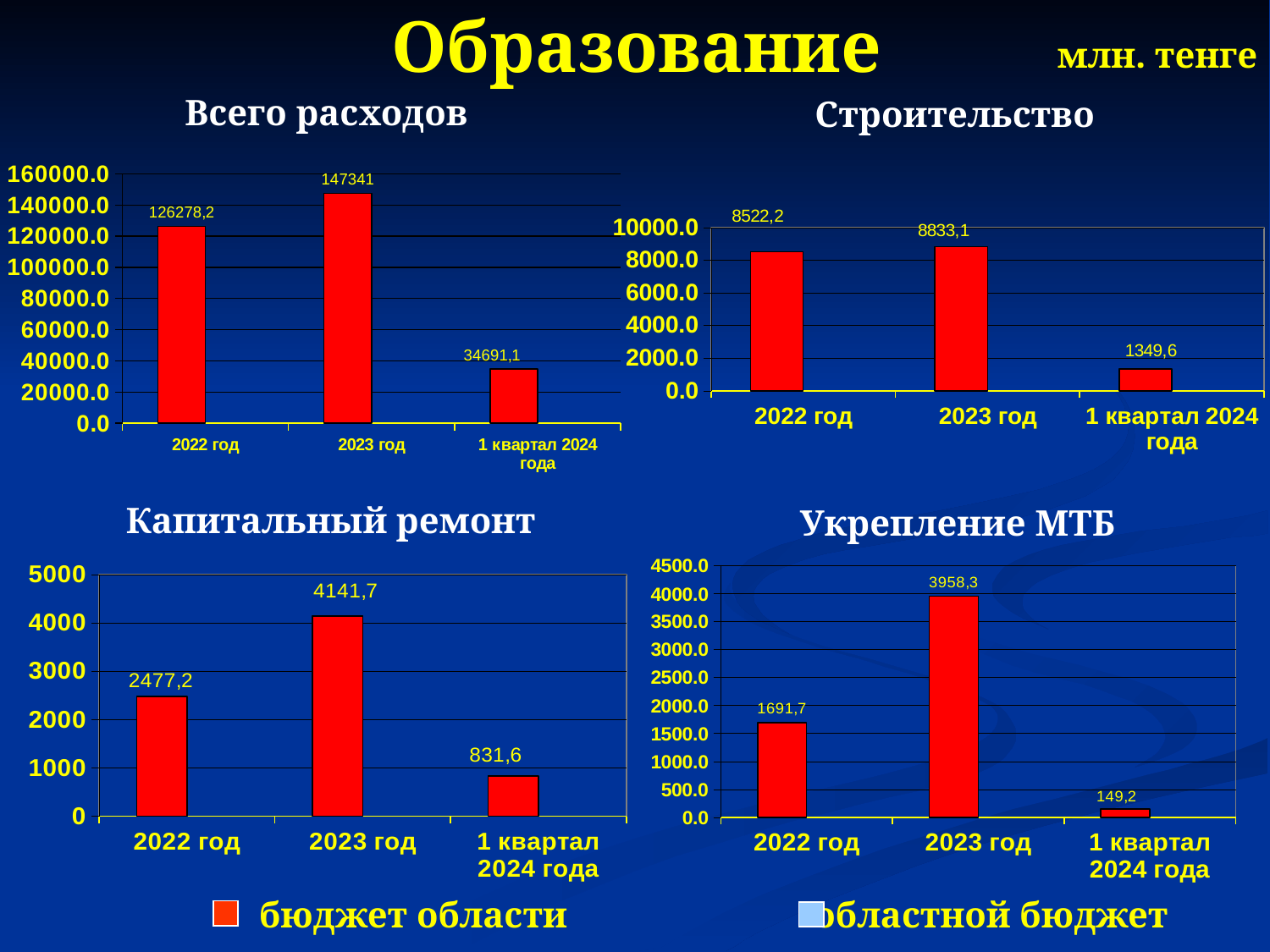
How many categories are shown in the "Строительство" chart? 3 In the "Укрепление МТБ" chart, is the value for 2023 год greater or less than 3500.0? greater What unit of measurement is stated at the top right of the slide? млн. тенге In the "Всего расходов" chart, what is the value for 2023 год? 147341 In the "Укрепление МТБ" chart, what is the value for 2022 год? 1691,7 In the "Капитальный ремонт" chart, what is the difference between the values for 2023 год and 2022 год? 1664,5 In the "Капитальный ремонт" chart, which category has the lowest value? 1 квартал 2024 года In the "Строительство" chart, which category has the highest value? 2023 год In the "Строительство" chart, what is the value for 1 квартал 2024 года? 1349,6 In the "Всего расходов" chart, what is the value for 1 квартал 2024 года? 34691,1 In the "Укрепление МТБ" chart, which is larger: the value for 2022 год or the value for 1 квартал 2024 года? 2022 год What type of chart is the "Капитальный ремонт" chart? bar chart